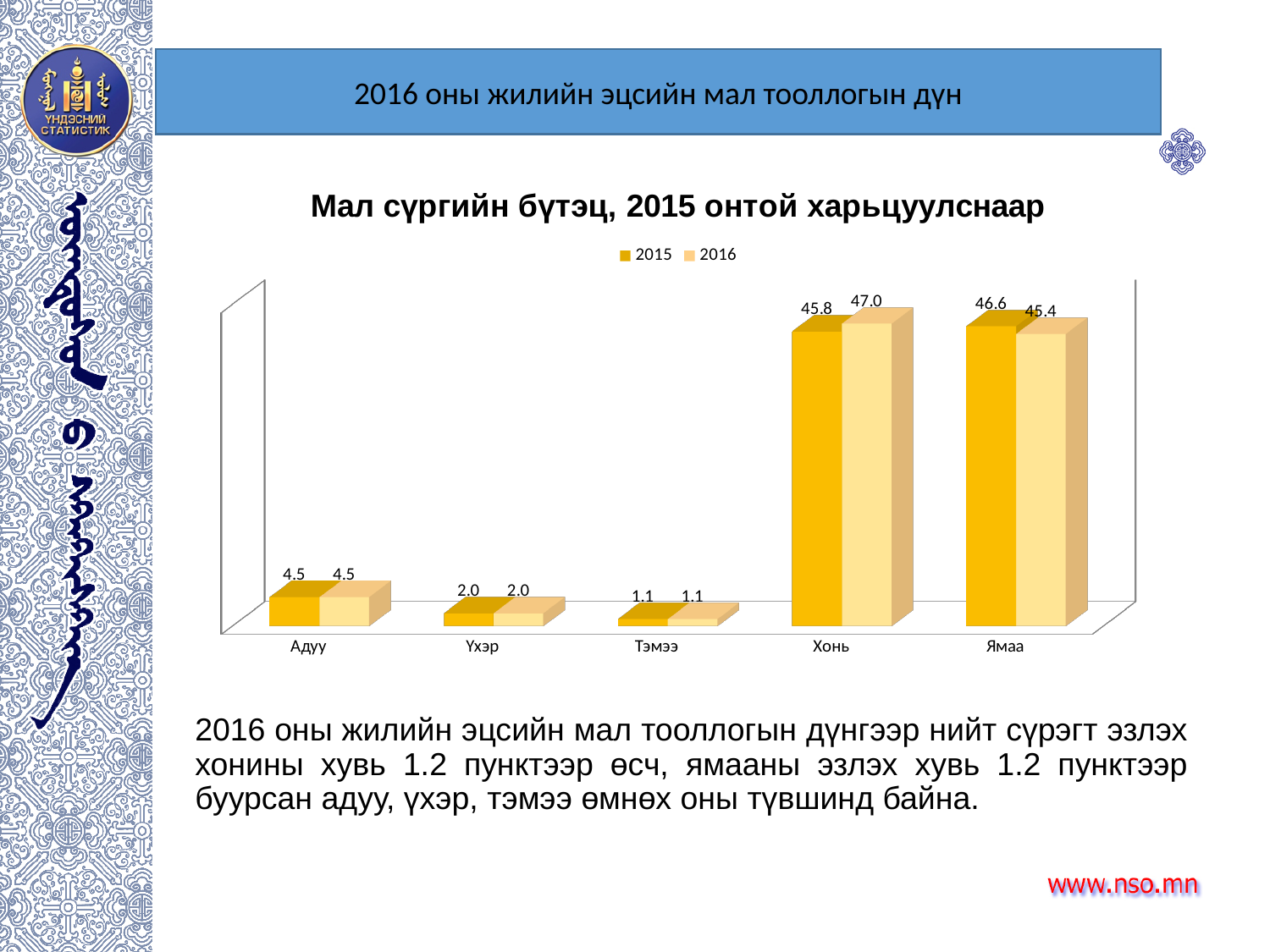
What is the difference between the 2016 and 2015 values for Хонь? 1.2 What is the 2016 value for Хонь? 47.0 Which is larger for Ямаа, the 2015 value or the 2016 value? 2015 Which category has the lowest 2015 value? Тэмээ What kind of chart is shown on the slide? Bar chart What is the difference between the 2015 and 2016 values for Ямаа? 1.2 What is the 2015 value for Адуу? 4.5 How many categories are shown on the x axis? 5 What is the 2015 value for Ямаа? 46.6 What is the 2016 value for Тэмээ? 1.1 Which category has the highest 2016 value? Хонь How many series does the legend list? 2